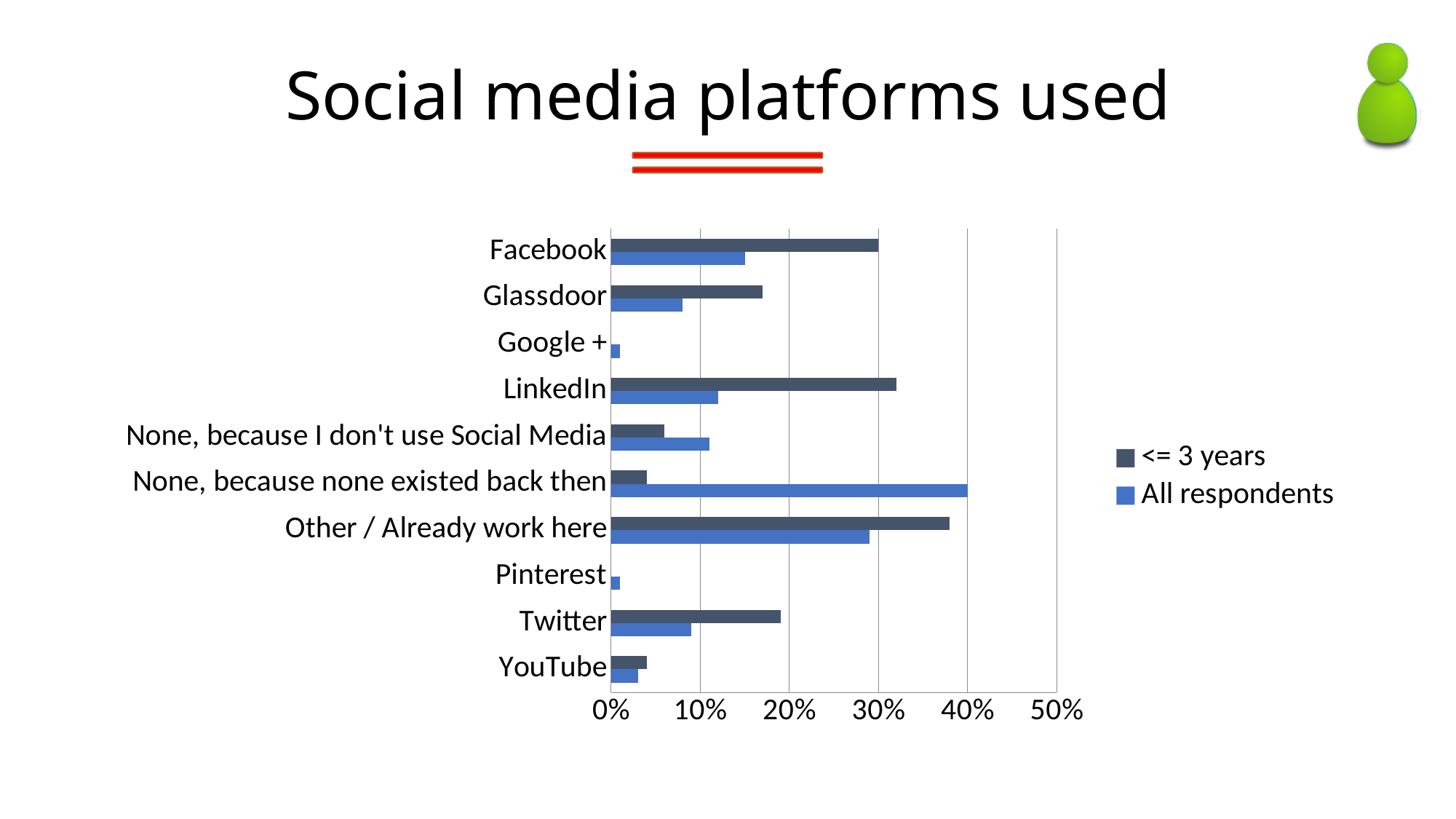
Which category has the highest value for All respondents? None, because none existed back then For 'None, because I don't use Social Media', which series has the larger value? All respondents What type of chart is shown on the slide? bar chart Is the All respondents value for Twitter greater or less than 10%? less For Glassdoor, which series has the larger value: <= 3 years or All respondents? <= 3 years What is the title of the slide? Social media platforms used Is the <= 3 years value for LinkedIn greater or less than 30%? greater How many series does the legend list? 2 Which category has the highest value for <= 3 years? Other / Already work here How many categories are shown on the chart? 10 What is the <= 3 years value for Facebook? 30% What is the All respondents value for 'None, because none existed back then'? 40%